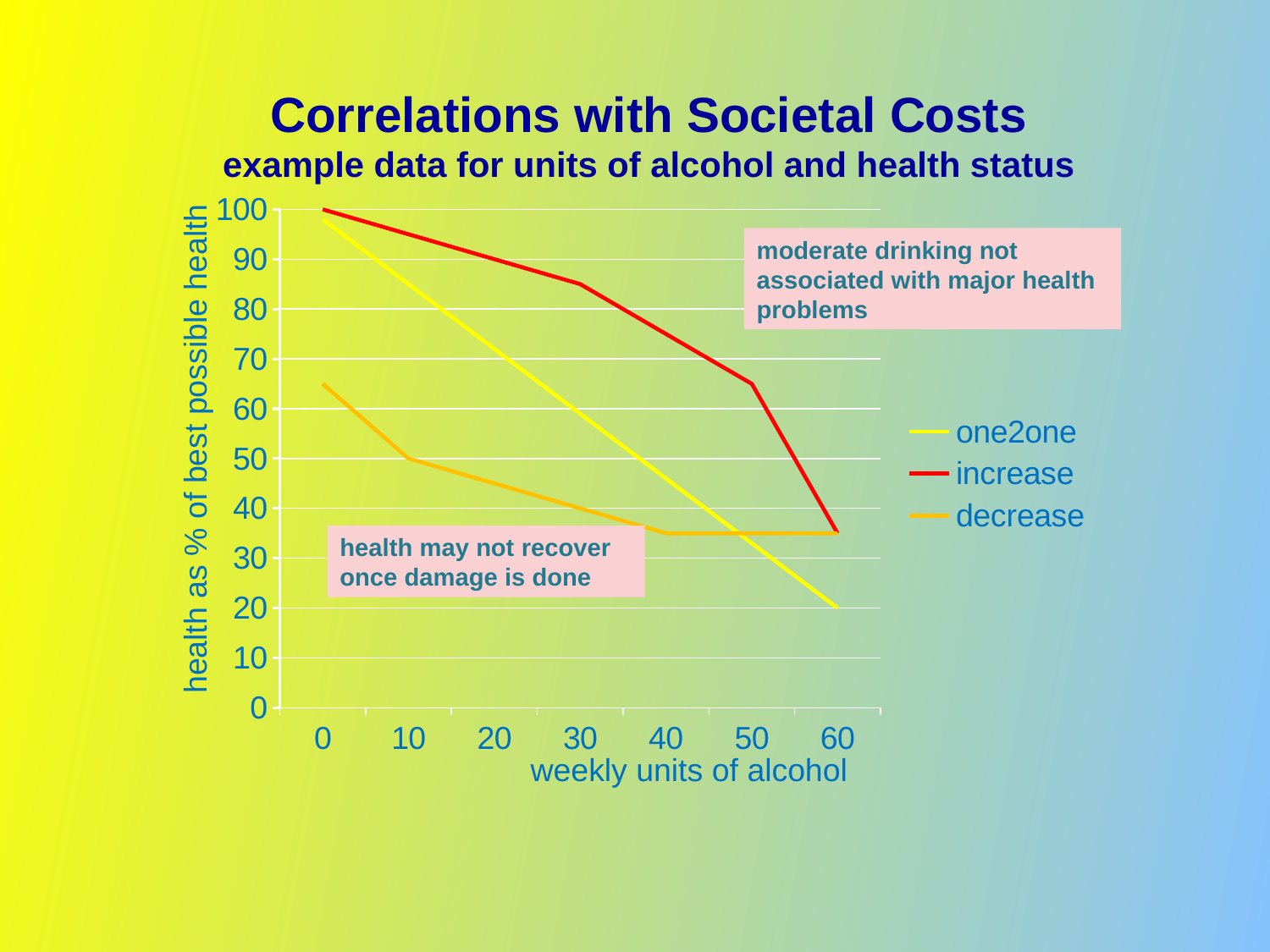
What is the value of the decrease series at 10 weekly units of alcohol? 50 What is the value of the increase series at 0 weekly units of alcohol? 100 What is the value of the one2one series at 60 weekly units of alcohol? 20 Is the value of the increase series at 30 weekly units of alcohol greater or less than 80? greater What kind of chart is shown on the slide? line chart Does the one2one series rise or fall as weekly units of alcohol increase? fall At 30 weekly units of alcohol, which series has the higher value, increase or one2one? increase How many series does the legend list? 3 What is the label of the x axis? weekly units of alcohol Which series has the lowest value at 60 weekly units of alcohol? one2one Is the value of the decrease series at 40 weekly units of alcohol greater or less than 40? less